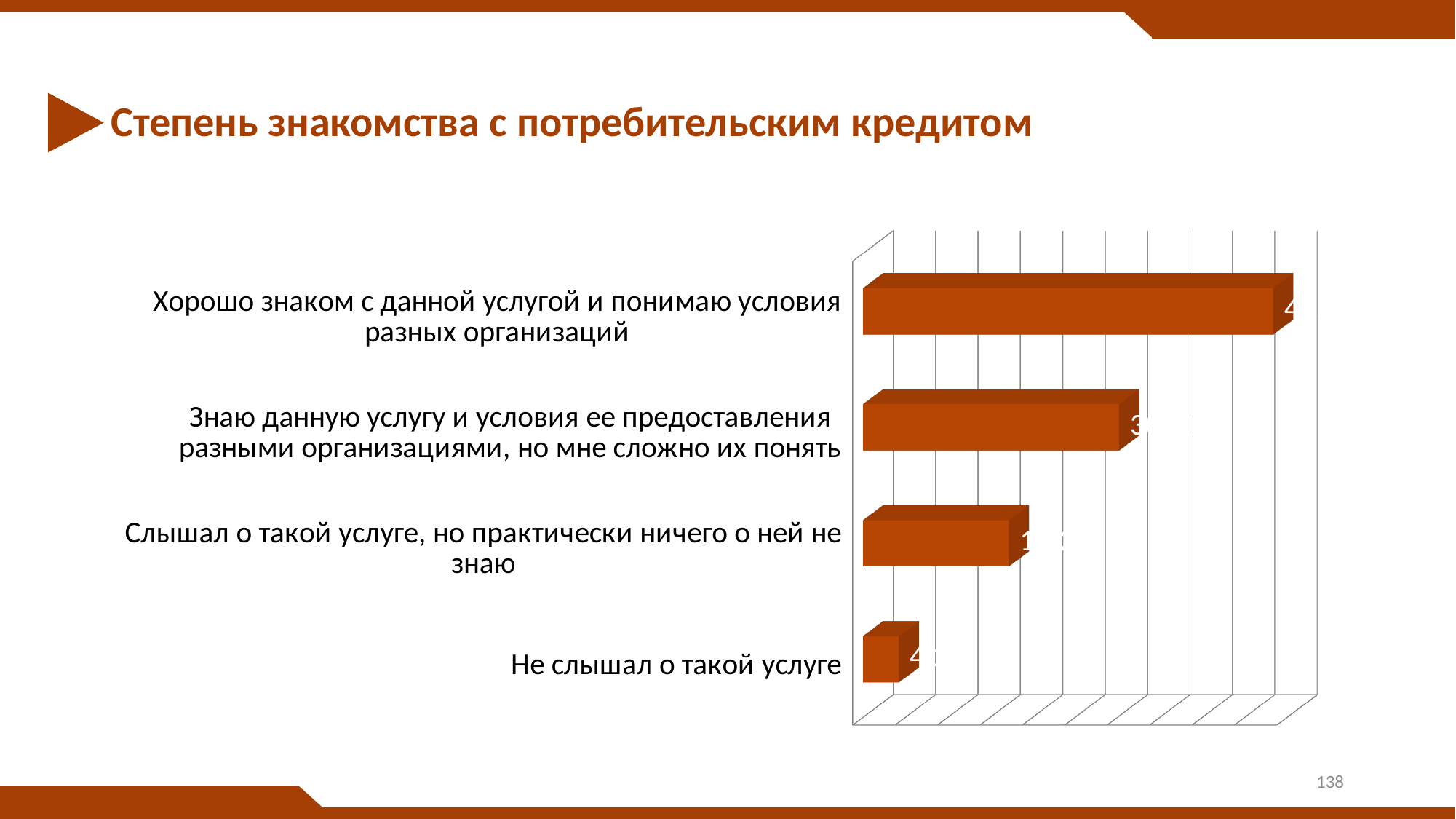
Which category has the highest value? Хорошо знаком с данной услугой и понимаю условия разных организаций Which category has the lowest value? Не слышал о такой услуге Which is larger: the value for "Не слышал о такой услуге" or the value for "Хорошо знаком с данной услугой и понимаю условия разных организаций"? Хорошо знаком с данной услугой и понимаю условия разных организаций Which is larger: the value for "Знаю данную услугу и условия ее предоставления разными организациями, но мне сложно их понять" or the value for "Слышал о такой услуге, но практически ничего о ней не знаю"? Знаю данную услугу и условия ее предоставления разными организациями, но мне сложно их понять What kind of chart is shown on the slide? bar chart Do the bar values increase or decrease going from the top category to the bottom category? decrease What is the title of the chart on the slide? Степень знакомства с потребительским кредитом Which category has the second-highest value? Знаю данную услугу и условия ее предоставления разными организациями, но мне сложно их понять What colour are the bars in the chart? orange-brown How many categories does the chart show? 4